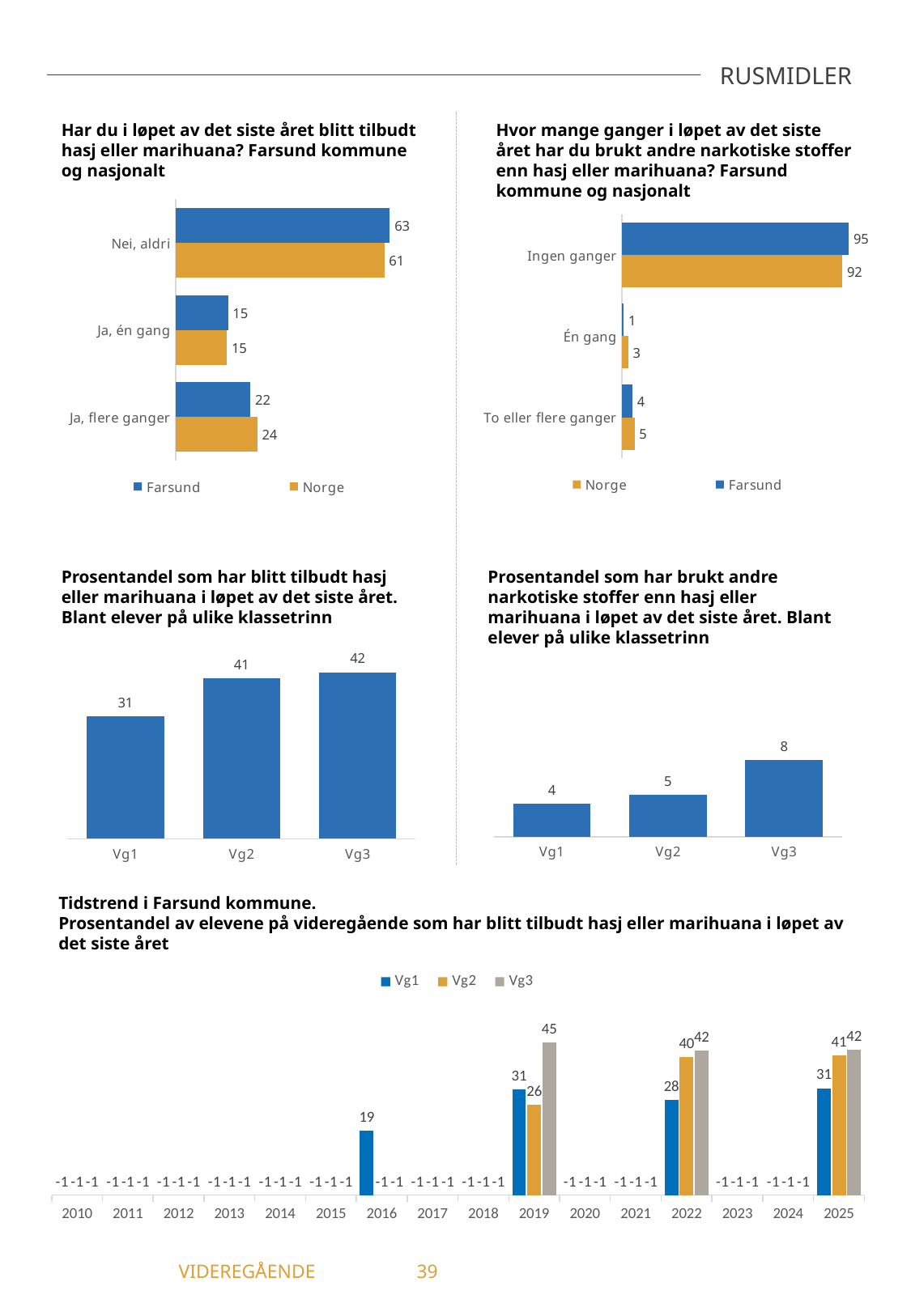
In the chart 'Prosentandel som har brukt andre narkotiske stoffer enn hasj eller marihuana i løpet av det siste året. Blant elever på ulike klassetrinn', which class level has the highest value? Vg3 In the chart 'Prosentandel som har brukt andre narkotiske stoffer enn hasj eller marihuana i løpet av det siste året. Blant elever på ulike klassetrinn', do the values rise or fall from Vg1 to Vg3? rise What kind of chart is 'Tidstrend i Farsund kommune'? bar chart In the chart 'Tidstrend i Farsund kommune', what is the value for Vg1 in 2016? 19 In the chart 'Hvor mange ganger i løpet av det siste året har du brukt andre narkotiske stoffer enn hasj eller marihuana?', which is larger for 'Én gang': Farsund or Norge? Norge In the chart 'Har du i løpet av det siste året blitt tilbudt hasj eller marihuana?', what is the value for Farsund in the category 'Nei, aldri'? 63 In the chart 'Hvor mange ganger i løpet av det siste året har du brukt andre narkotiske stoffer enn hasj eller marihuana?', what is the value for Norge in the category 'Ingen ganger'? 92 In the chart 'Tidstrend i Farsund kommune', what is the value for Vg3 in 2019? 45 In the chart 'Prosentandel som har blitt tilbudt hasj eller marihuana i løpet av det siste året. Blant elever på ulike klassetrinn', what is the value for Vg2? 41 How many series does the legend list in the chart 'Hvor mange ganger i løpet av det siste året har du brukt andre narkotiske stoffer enn hasj eller marihuana?'? 2 In the chart 'Prosentandel som har blitt tilbudt hasj eller marihuana i løpet av det siste året. Blant elever på ulike klassetrinn', which class level has the lowest value? Vg1 In the chart 'Har du i løpet av det siste året blitt tilbudt hasj eller marihuana?', what is the difference between Norge and Farsund for 'Ja, flere ganger'? 2